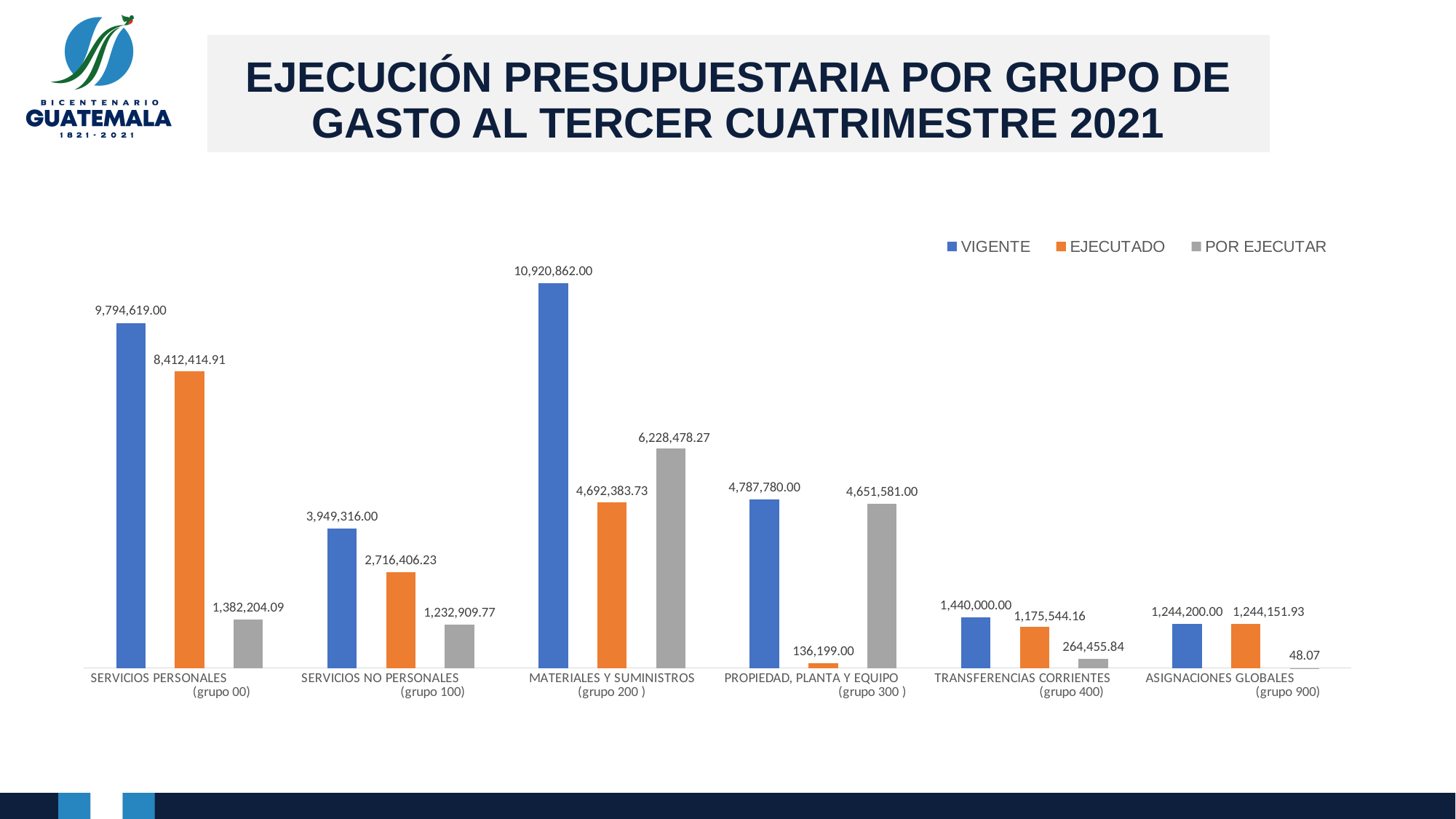
What is the difference between the VIGENTE and EJECUTADO values for SERVICIOS PERSONALES (grupo 00)? 1,382,204.09 How many series does the legend list? 3 What kind of chart is shown on the slide? Bar chart What is the POR EJECUTAR value for ASIGNACIONES GLOBALES (grupo 900)? 48.07 Which category has the highest VIGENTE value? MATERIALES Y SUMINISTROS (grupo 200) How many categories are shown on the x axis? 6 What is the VIGENTE value for MATERIALES Y SUMINISTROS (grupo 200)? 10,920,862.00 Which category has the lowest EJECUTADO value? PROPIEDAD, PLANTA Y EQUIPO (grupo 300) Which series is shown in orange in the legend? EJECUTADO What is the EJECUTADO value for PROPIEDAD, PLANTA Y EQUIPO (grupo 300)? 136,199.00 What is the EJECUTADO value for SERVICIOS NO PERSONALES (grupo 100)? 2,716,406.23 Which is larger: the EJECUTADO value for SERVICIOS PERSONALES (grupo 00) or for MATERIALES Y SUMINISTROS (grupo 200)? SERVICIOS PERSONALES (grupo 00)